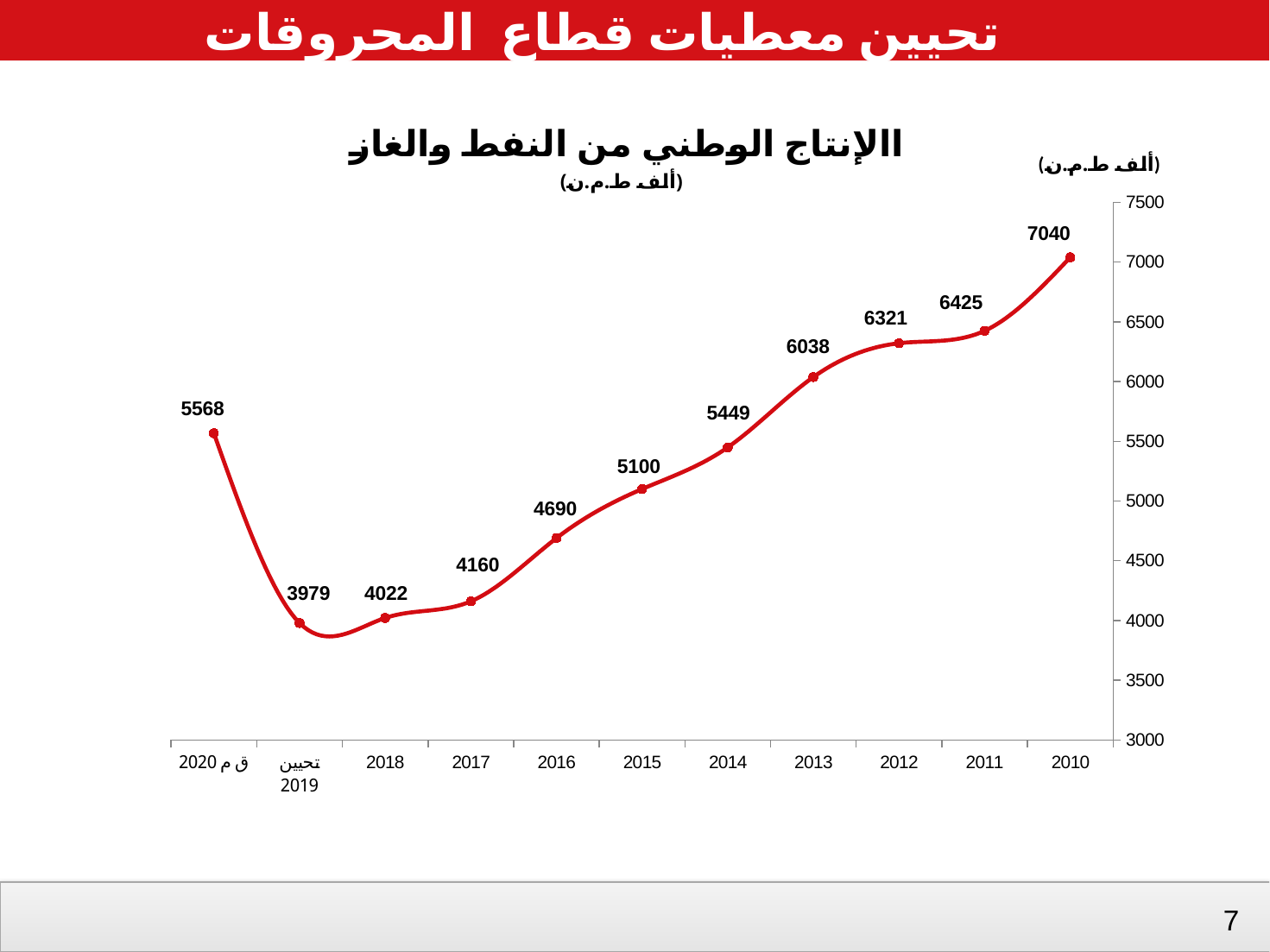
What is the value for ق م 2020 in the chart? 5568 Do the values rise or fall from 2010 to 2018? fall How many data points are plotted in the chart? 11 What is the value for 2015 in the chart? 5100 What is the value for 2010 in the chart? 7040 What is the difference between the values for 2010 and 2011? 615 What is the difference between the values for 2014 and 2015? 349 What kind of chart is shown on the slide? line chart Which year has the highest value in the chart? 2010 What is the value for تحيين 2019 in the chart? 3979 Which category has the lowest value in the chart? تحيين 2019 Which is larger, the value for 2017 or the value for 2018? 2017